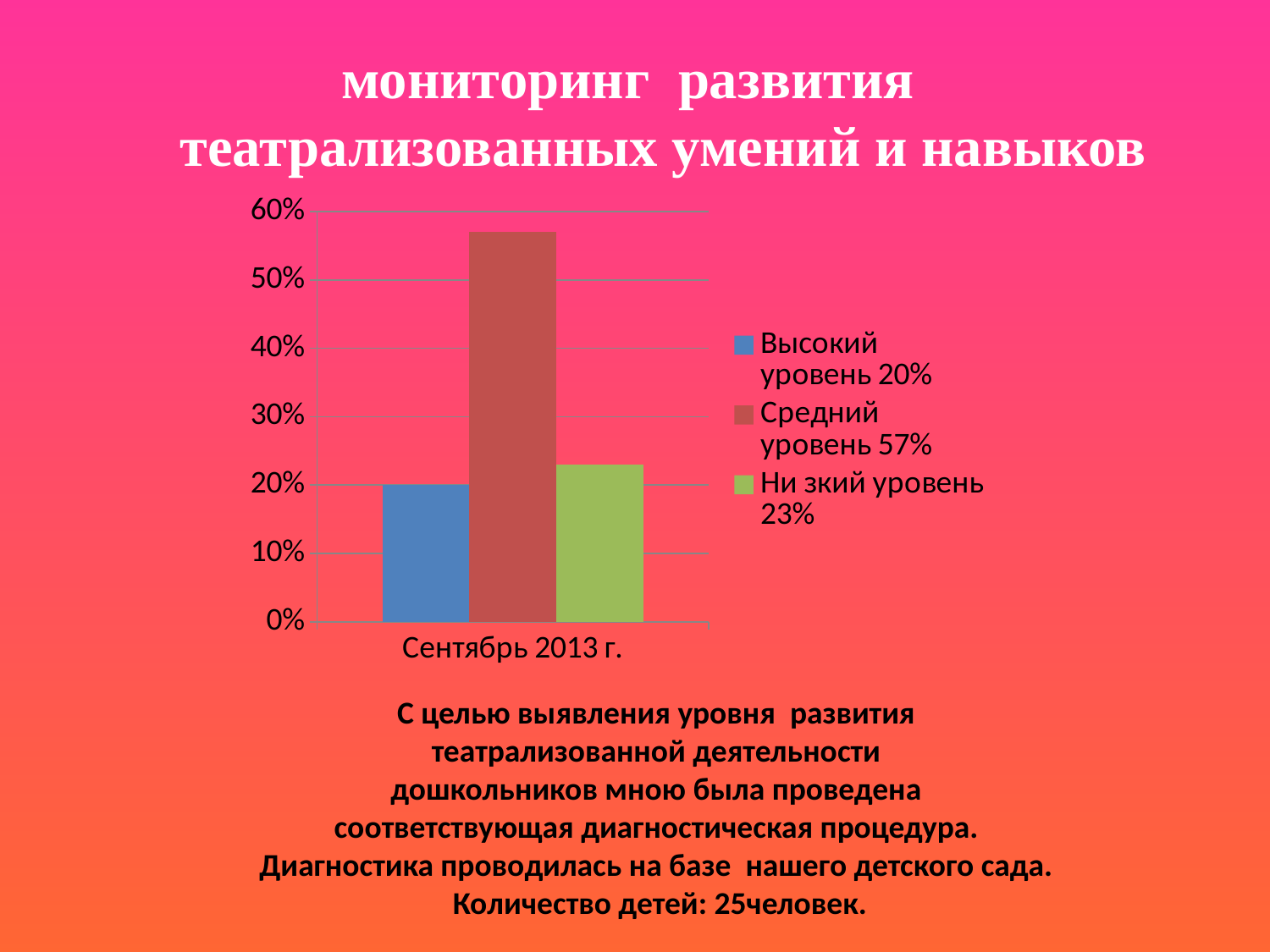
Is the value for Средний уровень greater or less than 50%? greater How many categories are shown on the x axis? 1 What value does the legend give for Средний уровень? 57% Which level has the lowest value? Высокий уровень Which is larger, Низкий уровень or Высокий уровень? Низкий уровень What kind of chart is shown on the slide? bar chart What value does the legend give for Низкий уровень? 23% What is the difference between Средний уровень and Низкий уровень? 34% Which level has the highest value? Средний уровень What value does the legend give for Высокий уровень? 20% How many series does the legend list? 3 What is the category label on the x axis? Сентябрь 2013 г.